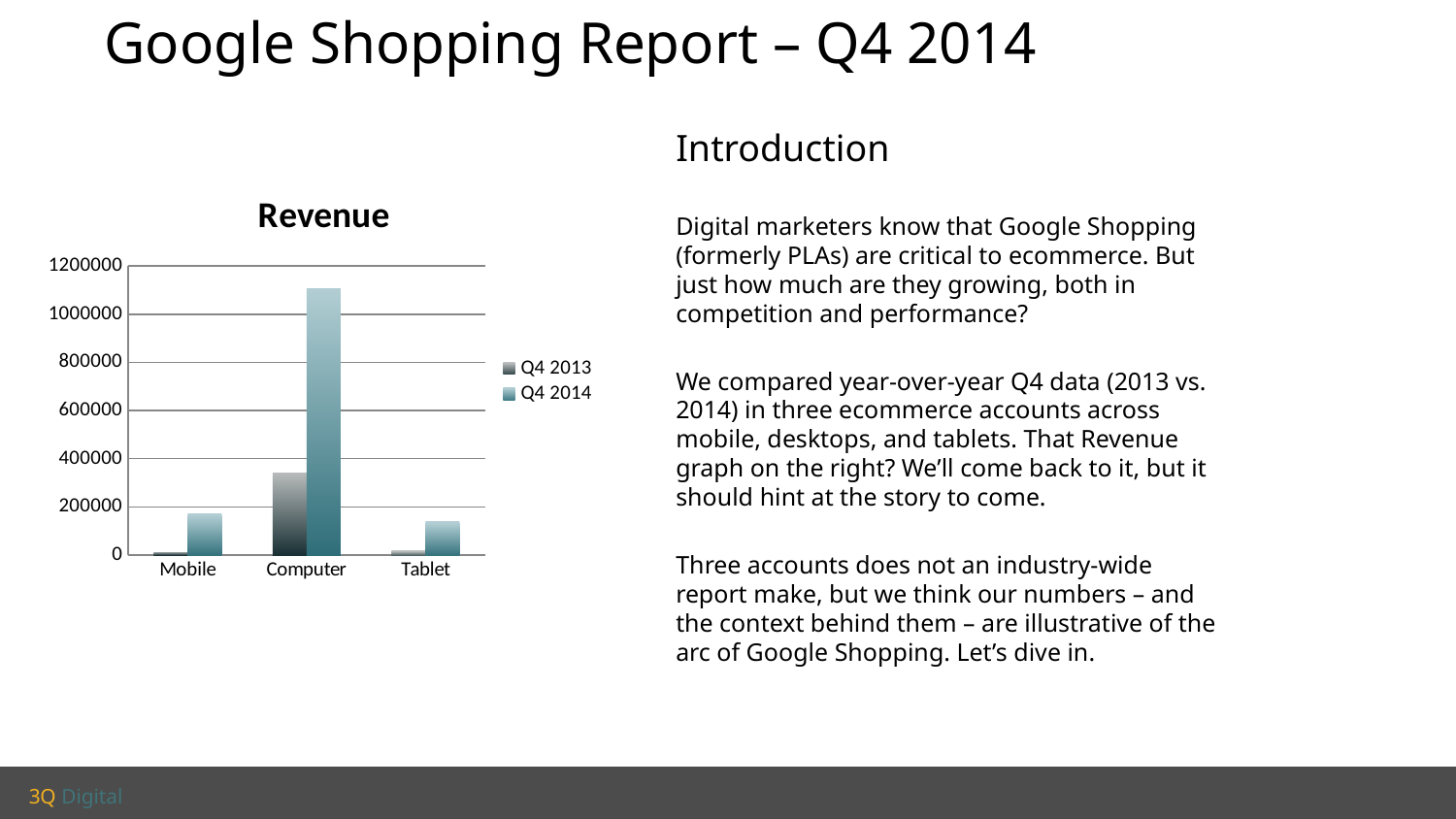
What is the title of the chart on the slide? Revenue Which category has the highest Q4 2013 revenue in the Revenue chart? Computer What type of chart is shown under the title "Revenue"? bar chart For Computer, which series has the larger value, Q4 2013 or Q4 2014? Q4 2014 Is the Q4 2014 value for Computer greater or less than 1000000? greater How many categories are shown on the x axis of the Revenue chart? 3 Is the Q4 2014 value for Mobile greater or less than 200000? less How many series does the legend of the Revenue chart list? 2 Is the Q4 2013 value for Computer greater or less than 400000? less Which category has the highest Q4 2014 revenue in the Revenue chart? Computer Which series is shown in the darker grey bars in the Revenue chart? Q4 2013